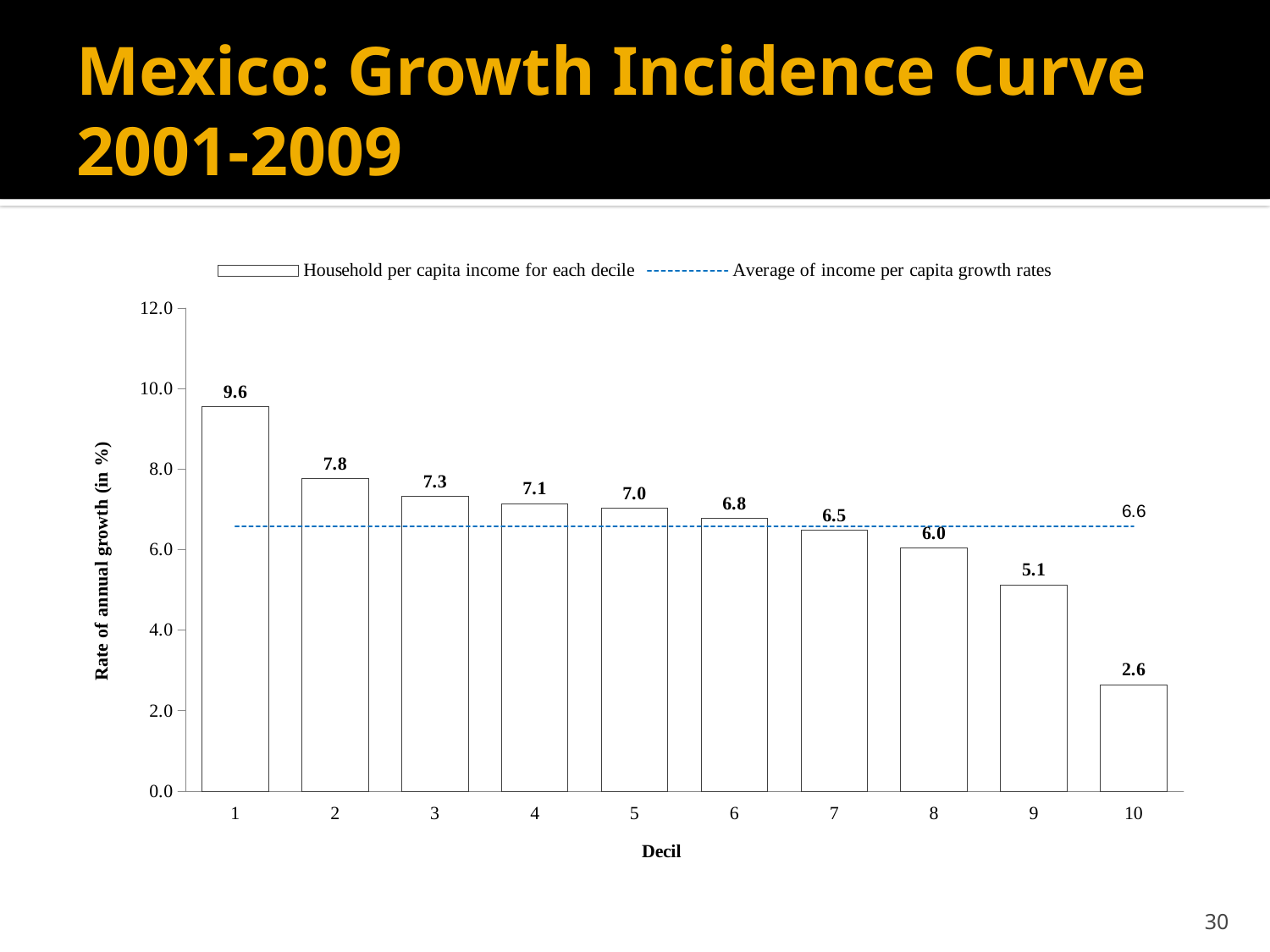
What is the rate of annual growth for decile 10? 2.6 What is the value of the average of income per capita growth rates line? 6.6 Which decile has the highest rate of annual growth? 1 Which has a higher rate of annual growth, decile 8 or decile 9? Decile 8 Which decile has the lowest rate of annual growth? 10 Is the value for decile 9 greater or less than 6.0? less Do the growth rates rise or fall as the decile increases from 1 to 10? Fall What is the difference between the growth rates of decile 1 and decile 10? 7.0 What is the rate of annual growth for decile 1? 9.6 What kind of chart is shown on the slide? Bar chart How many entries does the legend list? 2 How many deciles are shown on the x axis? 10